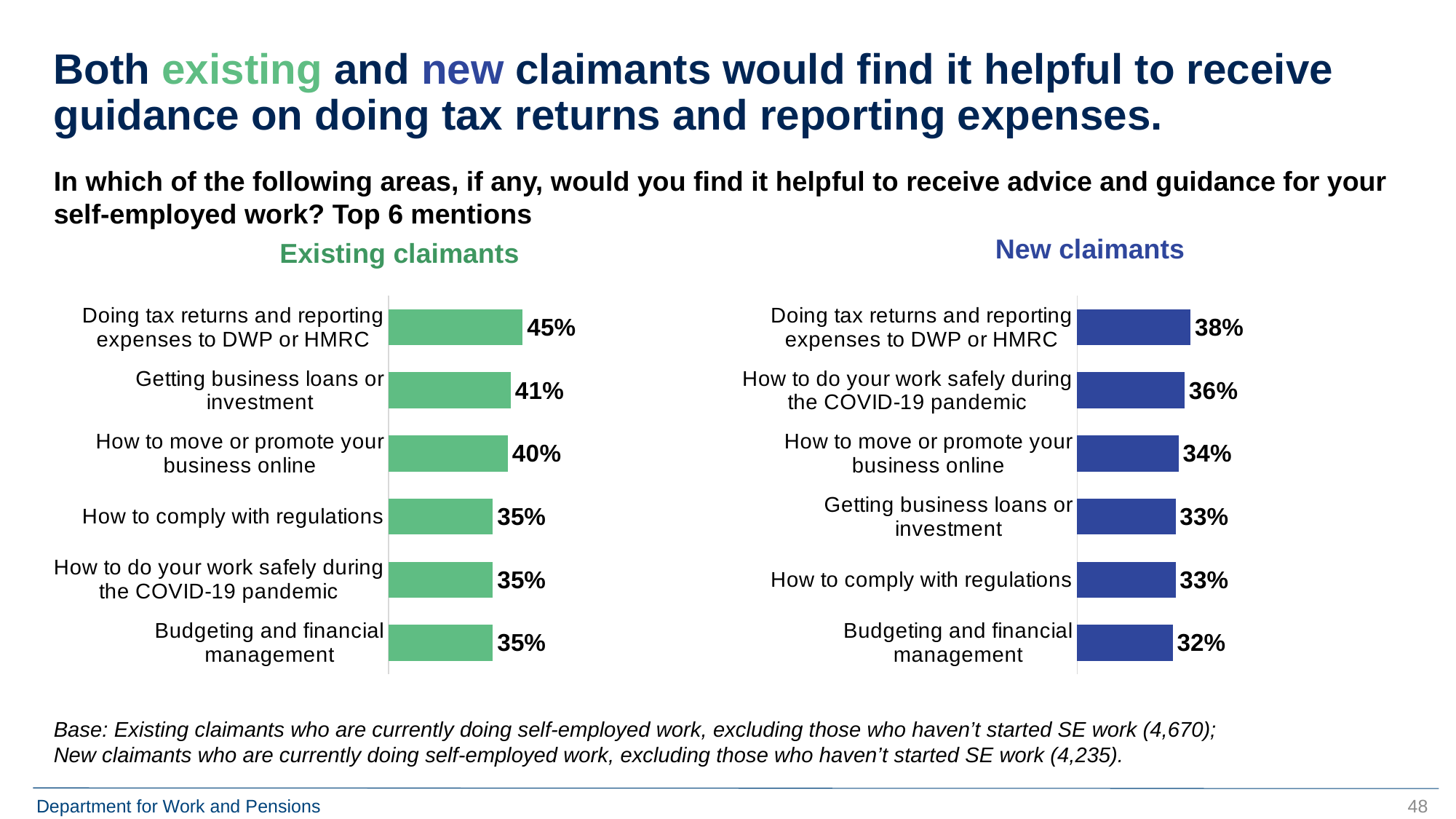
In the New claimants chart, which category has the lowest value? Budgeting and financial management In the New claimants chart, what percentage is shown for 'Getting business loans or investment'? 33% What colour are the bars in the Existing claimants chart? Green In the New claimants chart, which category has the highest value? Doing tax returns and reporting expenses to DWP or HMRC Which is larger: the Existing claimants value for 'How to move or promote your business online' or the New claimants value for the same category? Existing claimants (40%) What is the difference between the New claimants values for 'Doing tax returns and reporting expenses to DWP or HMRC' and 'Budgeting and financial management'? 6% What kind of chart is used for the New claimants data? Bar chart In the New claimants chart, what percentage is shown for 'How to do your work safely during the COVID-19 pandemic'? 36% In the Existing claimants chart, what is the difference between 'Doing tax returns and reporting expenses to DWP or HMRC' and 'Getting business loans or investment'? 4% How many categories are shown in the Existing claimants chart? 6 In the Existing claimants chart, what percentage is shown for 'Doing tax returns and reporting expenses to DWP or HMRC'? 45% In the Existing claimants chart, what percentage is shown for 'How to comply with regulations'? 35%